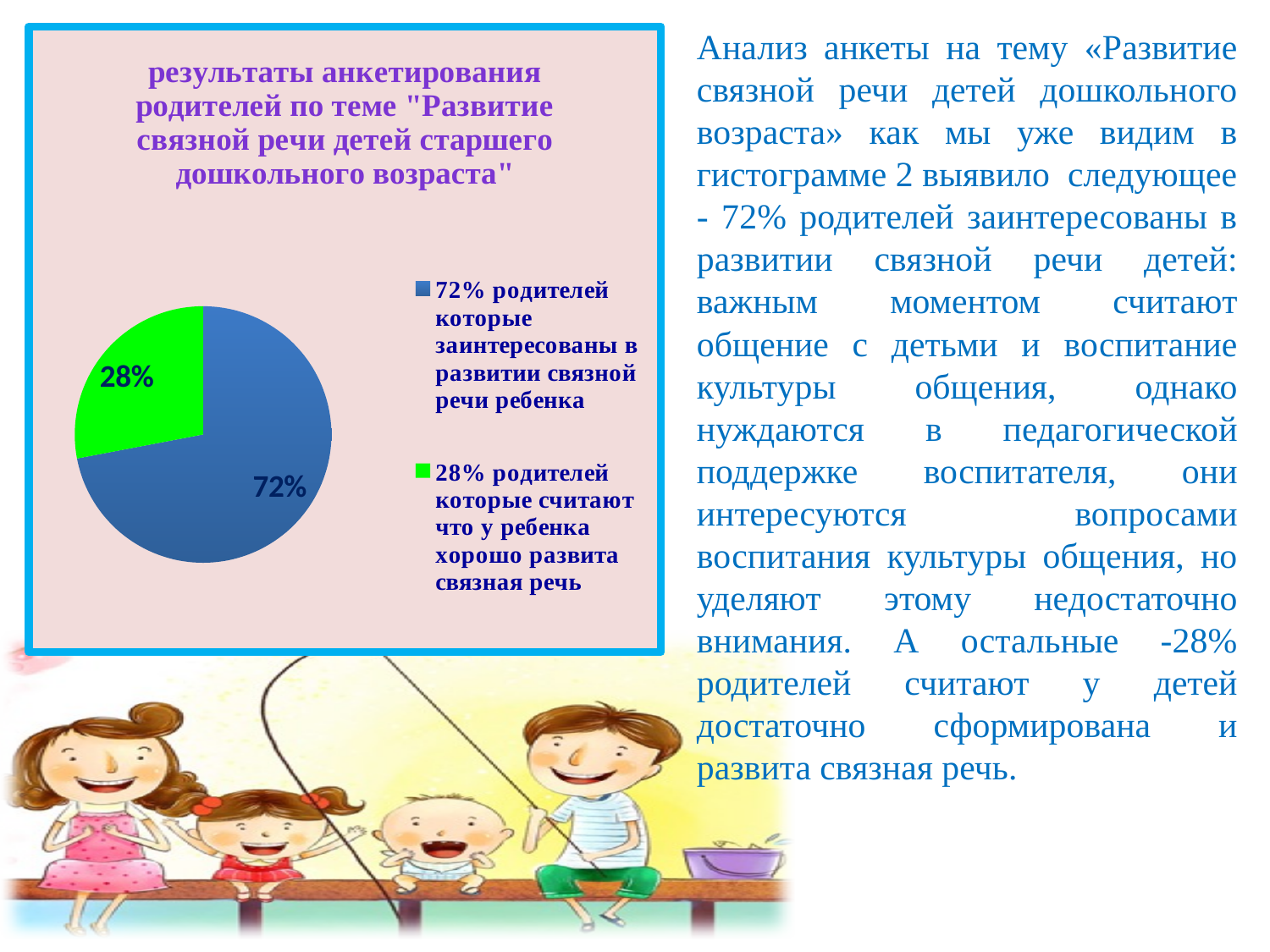
What share of the pie is taken by parents who believe their child's coherent speech is well developed? 28% What is the difference in percentage points between the two slices of the pie chart? 44 What is the total of the two slices shown in the pie chart? 100% Which is larger: the share of parents interested in developing coherent speech or the share who think it is already well developed? parents interested in developing coherent speech (72%) What colour is the 28% slice of the pie chart? green What share of the pie is taken by parents who are interested in developing their child's coherent speech? 72% What is the title of the pie chart? результаты анкетирования родителей по теме "Развитие связной речи детей старшего дошкольного возраста" How many slices does the pie chart have? 2 Which slice of the pie chart is the smallest? 28% родителей которые считают что у ребенка хорошо развита связная речь Which slice of the pie chart is the largest? 72% родителей которые заинтересованы в развитии связной речи ребенка How many entries does the legend of the pie chart list? 2 What kind of chart is shown on the slide? pie chart